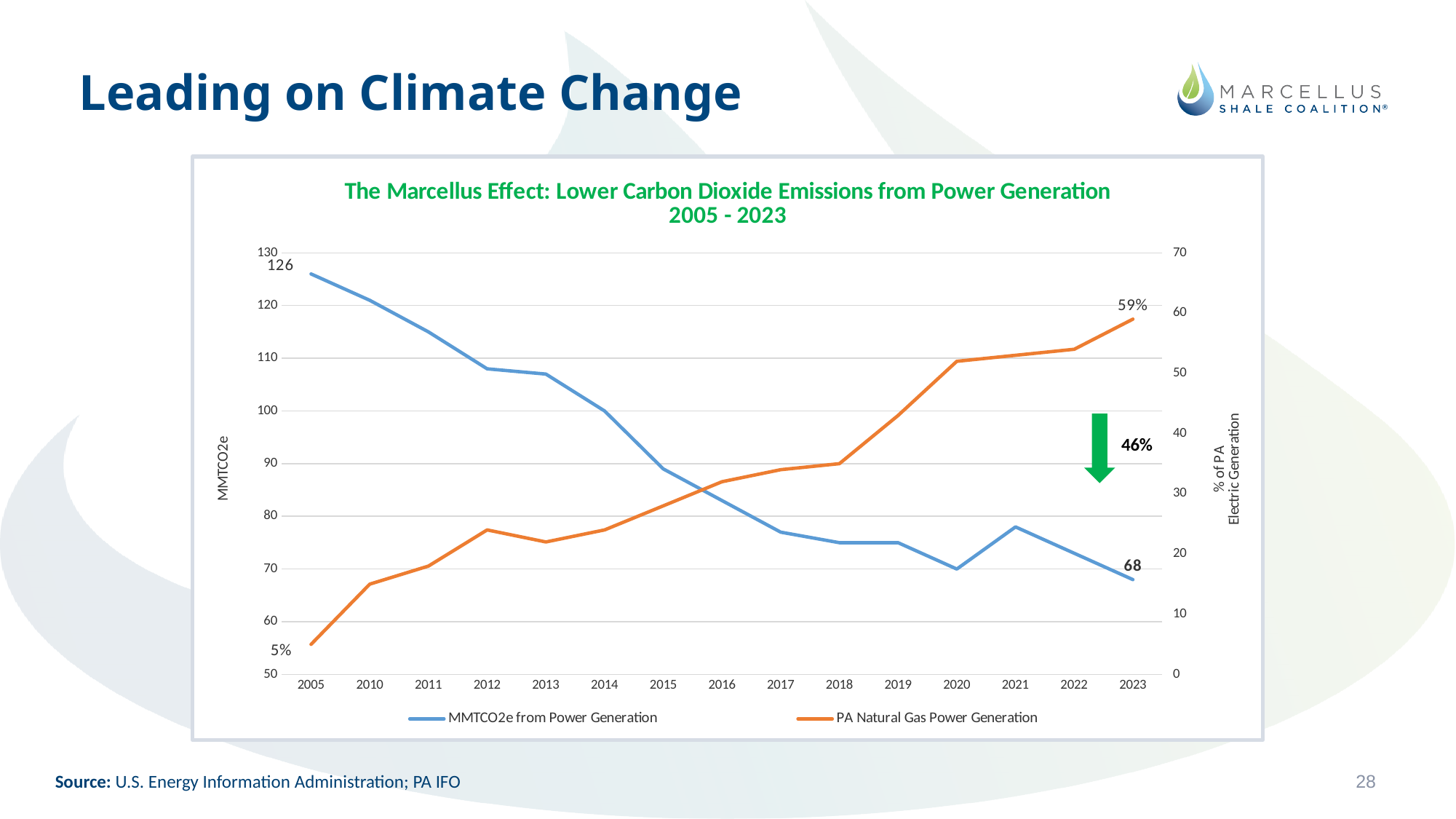
What is the MMTCO2e from Power Generation value in 2023? 68 Is the MMTCO2e from Power Generation value for 2012 greater or less than 100? greater How many years are plotted on the x axis? 15 Is the PA Natural Gas Power Generation value for 2018 greater or less than 40? less What is the PA Natural Gas Power Generation share in 2023? 59% What kind of chart is shown? line chart In which year is PA Natural Gas Power Generation highest? 2023 In which year is MMTCO2e from Power Generation highest? 2005 By how much did MMTCO2e from Power Generation fall between 2005 and 2023? 58 Does MMTCO2e from Power Generation rise or fall from 2005 to 2023? fall What is the PA Natural Gas Power Generation share in 2005? 5% What is the MMTCO2e from Power Generation value in 2005? 126